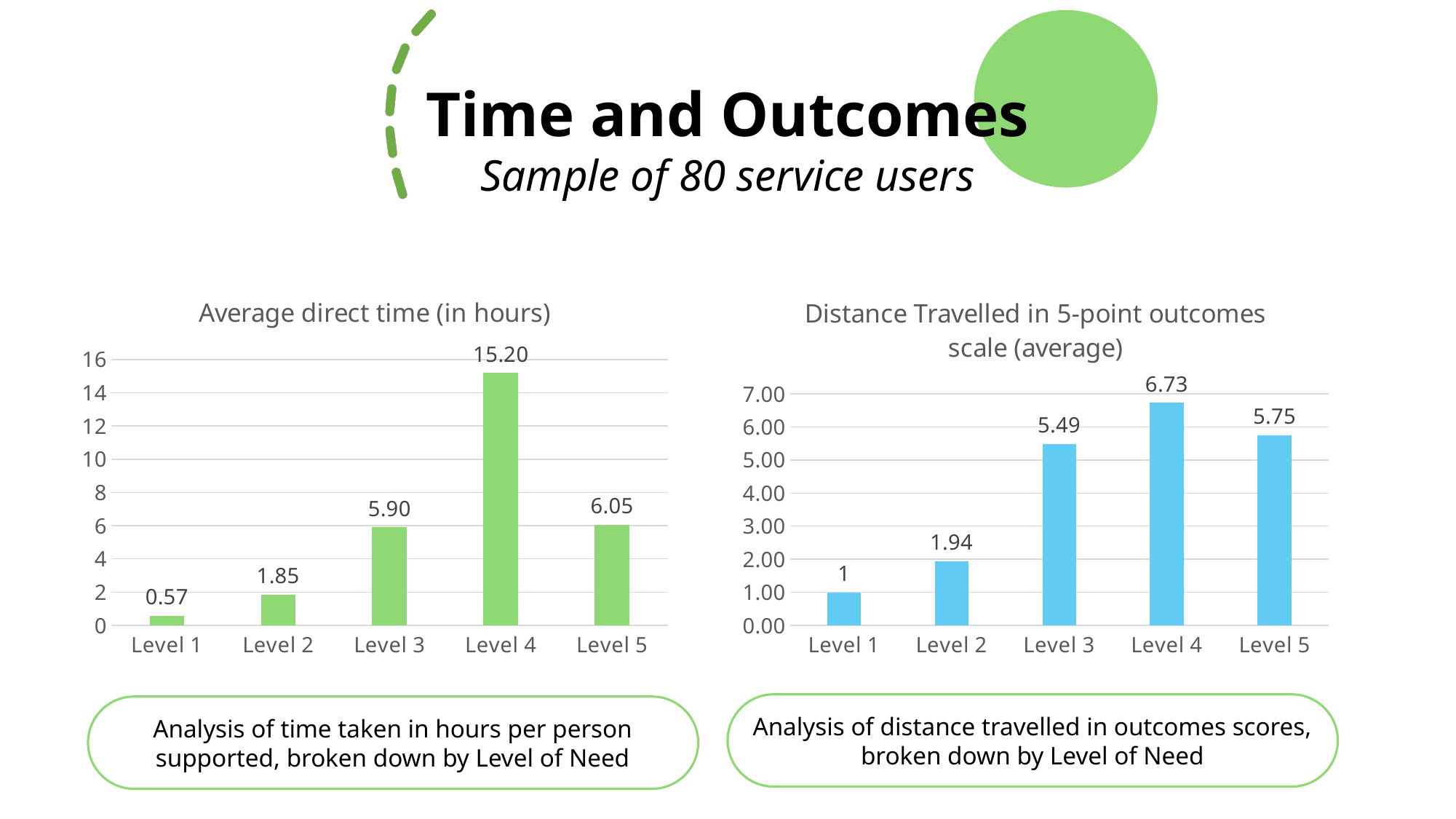
In the 'Average direct time (in hours)' chart, what is the difference between Level 5 and Level 3? 0.15 In the 'Distance Travelled in 5-point outcomes scale (average)' chart, which is larger, Level 2 or Level 1? Level 2 In the 'Average direct time (in hours)' chart, is the value for Level 2 greater or less than 2? less In the 'Distance Travelled in 5-point outcomes scale (average)' chart, what is the difference between Level 4 and Level 5? 0.98 In the 'Average direct time (in hours)' chart, which level has the lowest value? Level 1 In the 'Average direct time (in hours)' chart, what is the value for Level 4? 15.20 In the 'Distance Travelled in 5-point outcomes scale (average)' chart, what is the value for Level 3? 5.49 What colour are the bars in the 'Distance Travelled in 5-point outcomes scale (average)' chart? Blue In the 'Distance Travelled in 5-point outcomes scale (average)' chart, what is the value for Level 1? 1 What kind of chart is the 'Average direct time (in hours)' chart? Bar chart In the 'Distance Travelled in 5-point outcomes scale (average)' chart, which level has the highest value? Level 4 In the 'Average direct time (in hours)' chart, how many levels are shown? 5